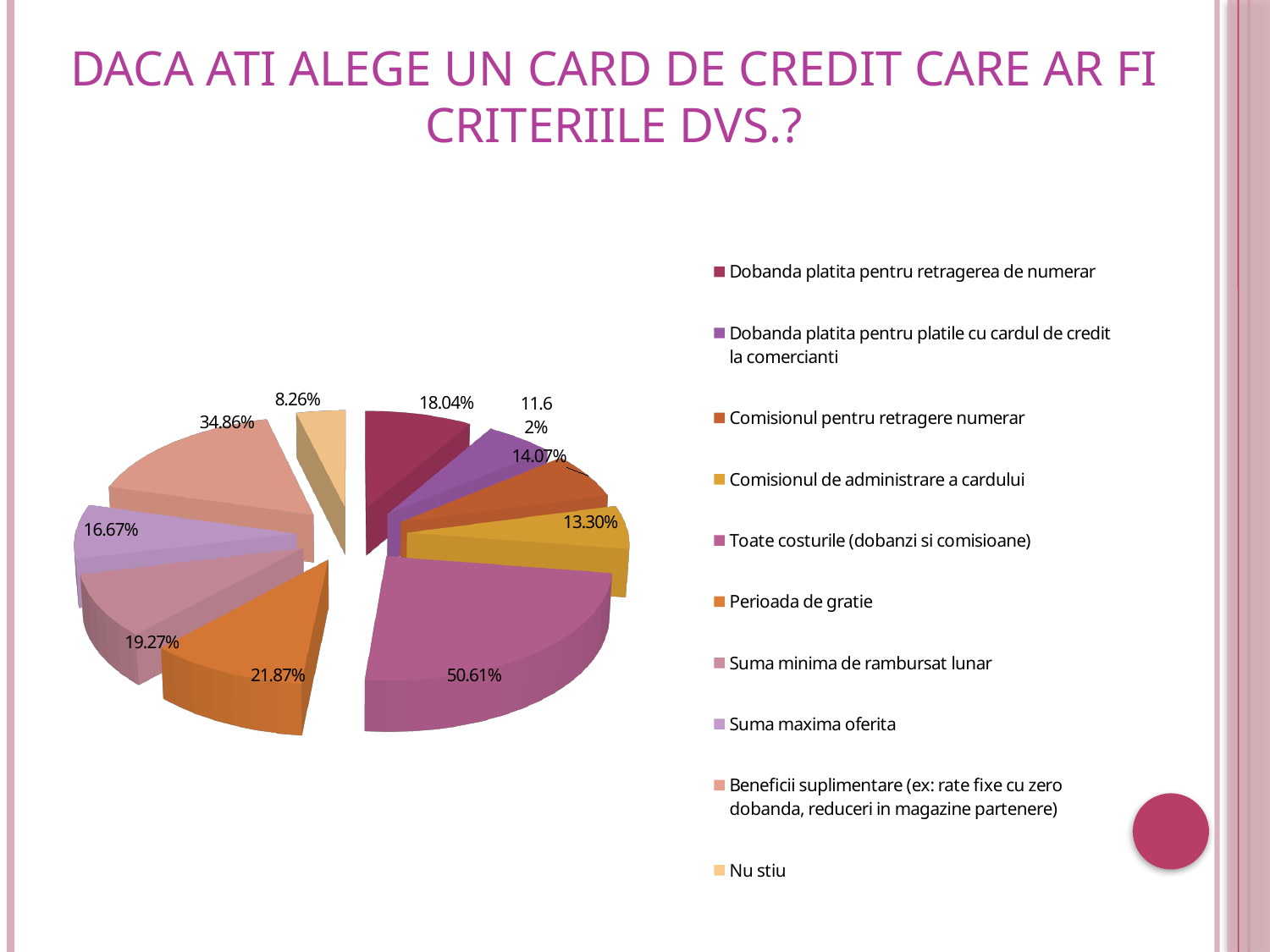
What is the title of the slide containing the pie chart? Daca ati alege un card de credit care ar fi criteriile dvs.? How many entries does the legend list? 10 What is the value shown for 'Nu stiu'? 8.26% What is the value shown for 'Toate costurile (dobanzi si comisioane)'? 50.61% How many slices does the pie chart have? 10 Which category has the smallest slice in the pie chart? Nu stiu What is the difference between the values for 'Toate costurile (dobanzi si comisioane)' and 'Beneficii suplimentare'? 15.75 percentage points What is the value shown for 'Perioada de gratie'? 21.87% What kind of chart is shown on the slide? Pie chart Which category has the largest slice in the pie chart? Toate costurile (dobanzi si comisioane) Which has the larger value: 'Suma minima de rambursat lunar' or 'Suma maxima oferita'? Suma minima de rambursat lunar What is the value shown for 'Beneficii suplimentare (ex: rate fixe cu zero dobanda, reduceri in magazine partenere)'? 34.86%